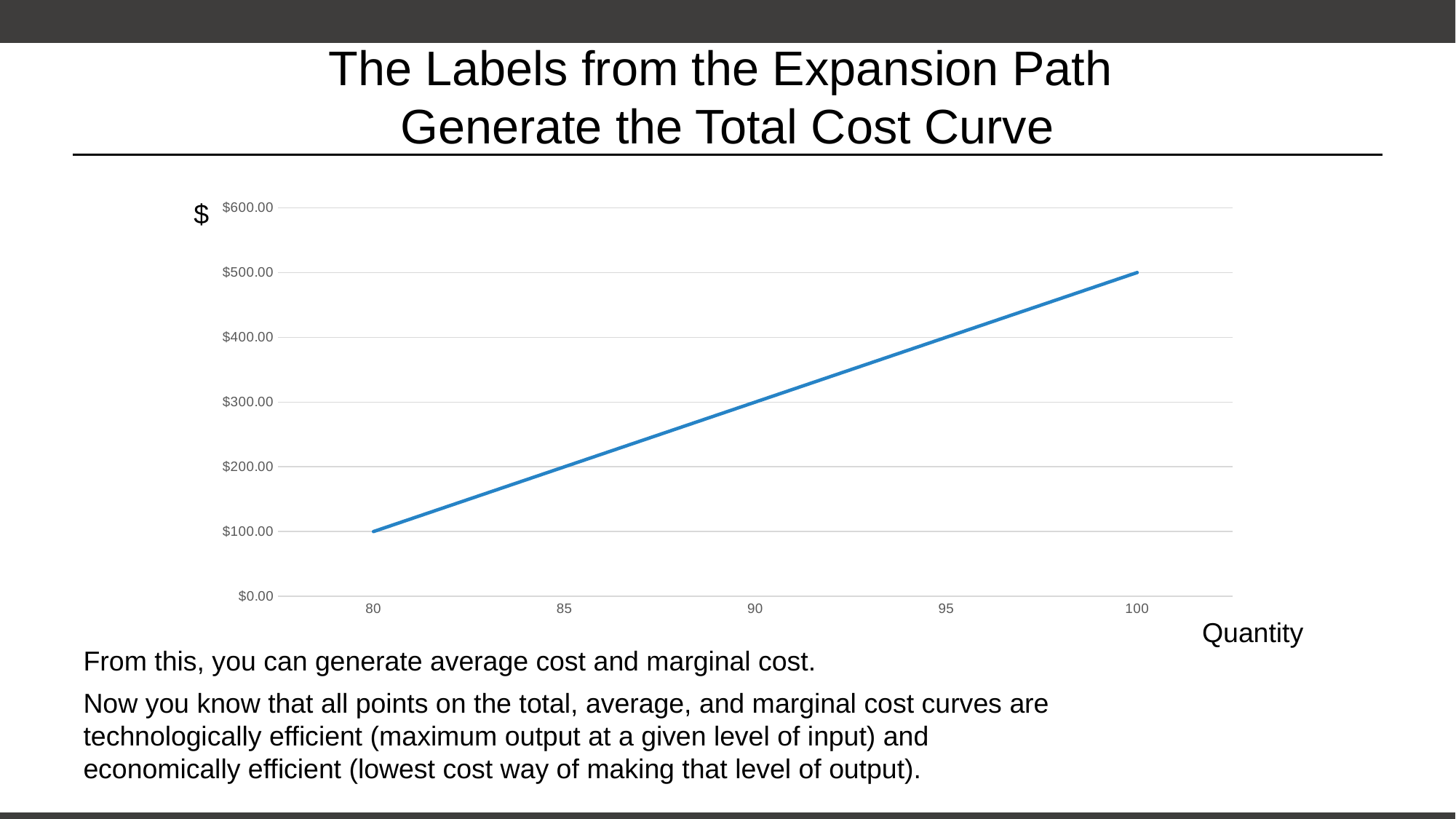
What is the total cost at a quantity of 80? $100.00 What is the total cost at a quantity of 100? $500.00 What is the label on the horizontal axis of the chart? Quantity Is the total cost at a quantity of 90 greater or less than $200.00? greater What is the difference between the total cost at a quantity of 100 and at a quantity of 80? $400.00 At which quantity shown on the x axis is the total cost highest? 100 Is the total cost at a quantity of 85 greater or less than $300.00? less Which quantity has the higher total cost, 80 or 100? 100 At which quantity shown on the x axis is the total cost lowest? 80 What kind of chart is shown on the slide? line chart Is the total cost at a quantity of 95 greater or less than $300.00? greater Does the total cost rise or fall as quantity increases from 80 to 100? rise